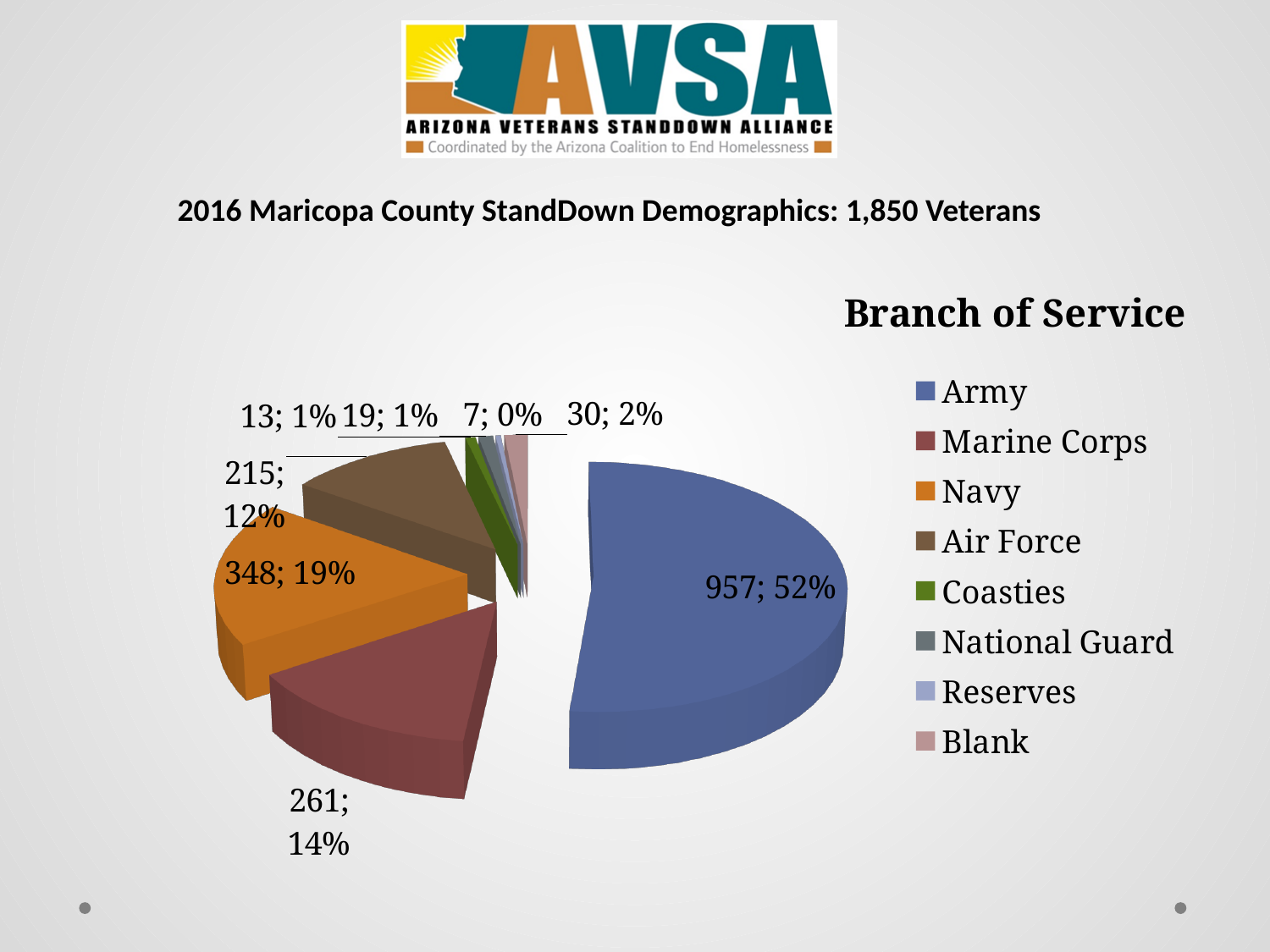
Which slice is larger in the Branch of Service pie chart, Navy or Marine Corps? Navy What is the title of the pie chart on the slide? Branch of Service How many veterans are in the Army slice of the Branch of Service pie chart? 957 What kind of chart is shown on the slide? pie chart What is the difference between the Army count and the Navy count in the Branch of Service pie chart? 609 Which branch of service has the largest slice in the pie chart? Army What is the difference between the Navy count and the Air Force count in the Branch of Service pie chart? 133 How many veterans are in the Air Force slice of the Branch of Service pie chart? 215 What share of the Branch of Service pie does Marine Corps represent? 14% What share of the Branch of Service pie does Army represent? 52% How many veterans are in the Navy slice of the Branch of Service pie chart? 348 How many categories does the legend of the Branch of Service pie chart list? 8